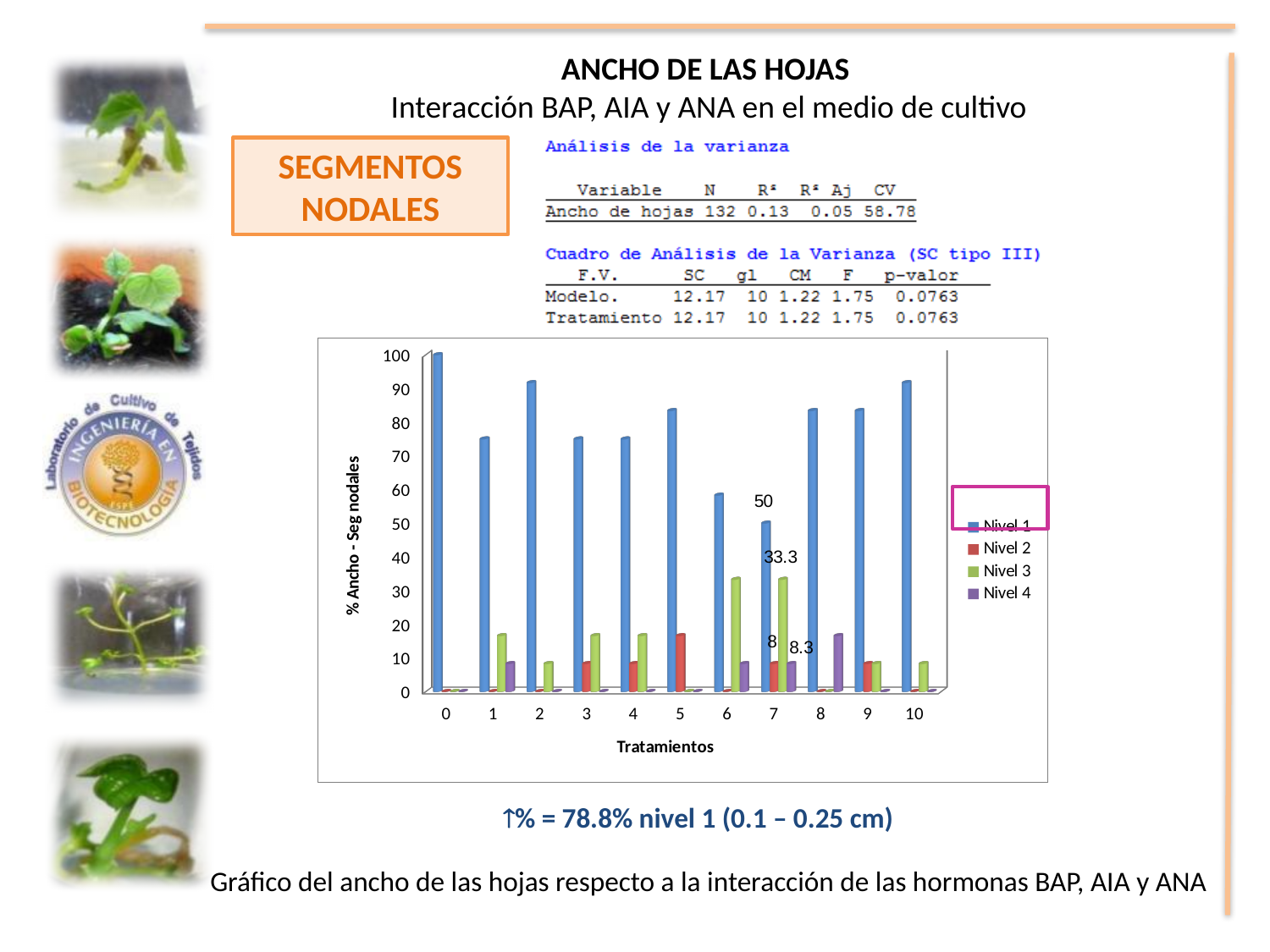
For treatment 7, which is larger: Nivel 1 or Nivel 3? Nivel 1 What is the value of Nivel 4 for treatment 7? 8.3 Is the Nivel 1 value for treatment 2 greater or less than 90? greater Which treatment has the lowest Nivel 1 value? 7 For treatment 7, what is the difference between the Nivel 1 value and the Nivel 3 value? 16.7 What is the value of Nivel 1 for treatment 7? 50 How many series does the chart legend list? 4 Which treatment has the highest Nivel 1 value? 0 What kind of chart is shown on the slide? bar chart What is the value of Nivel 2 for treatment 7? 8 How many treatments (Tratamientos) are shown on the x axis of the chart? 11 What is the value of Nivel 3 for treatment 7? 33.3